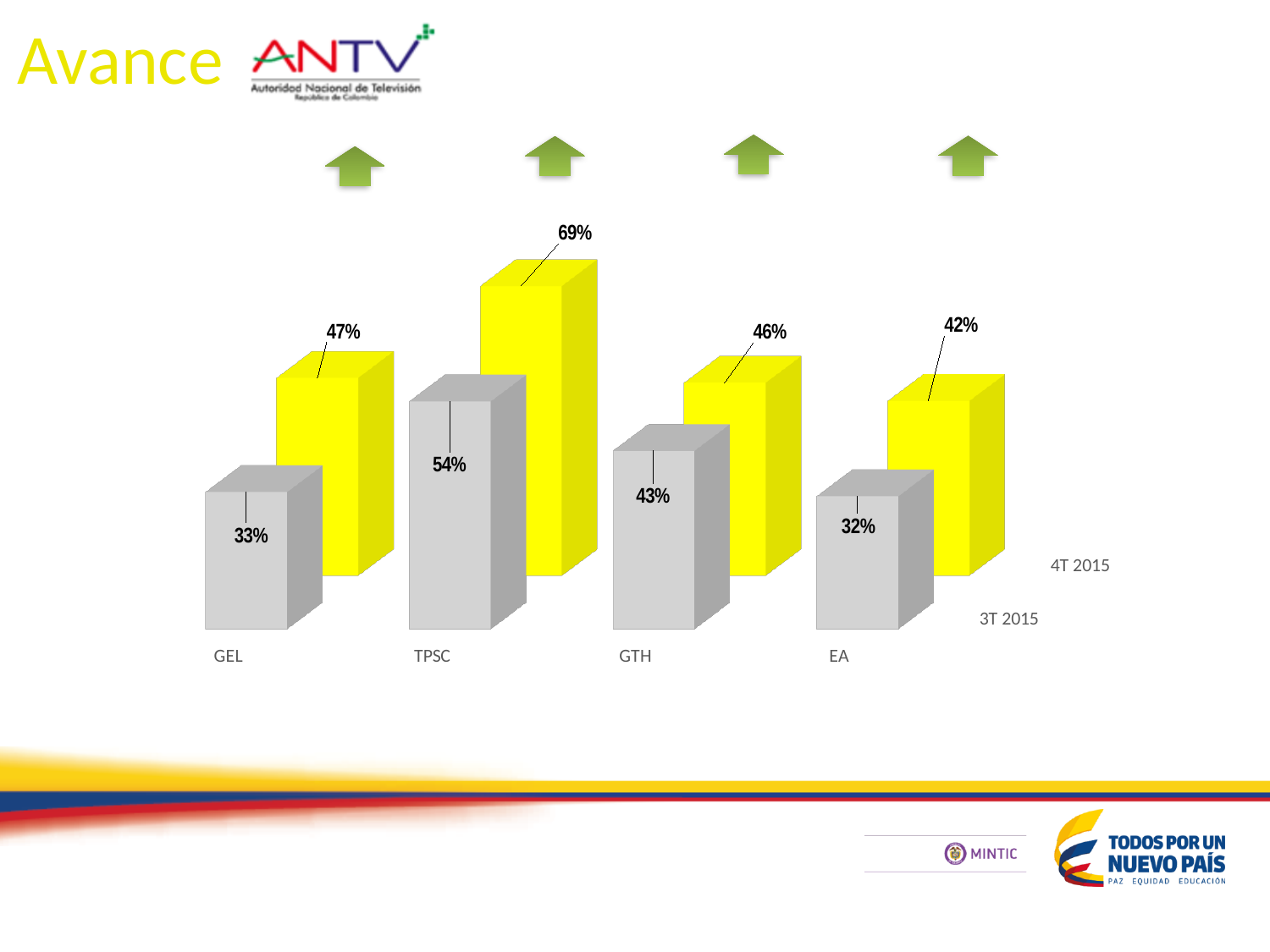
What is the value for EA in 4T 2015? 42% What is the difference between the 4T 2015 and 3T 2015 values for TPSC? 15% Which category has the highest value in 4T 2015? TPSC What is the value for GEL in 3T 2015? 33% Which category has the lowest value in 3T 2015? EA What is the difference between the 4T 2015 and 3T 2015 values for GEL? 14% How many series does the chart show? 2 How many categories are shown on the chart? 4 What is the value for TPSC in 4T 2015? 69% Which is larger, the 3T 2015 value for TPSC or the 4T 2015 value for GEL? 3T 2015 value for TPSC What kind of chart is shown on the slide? Bar chart What is the value for GTH in 3T 2015? 43%